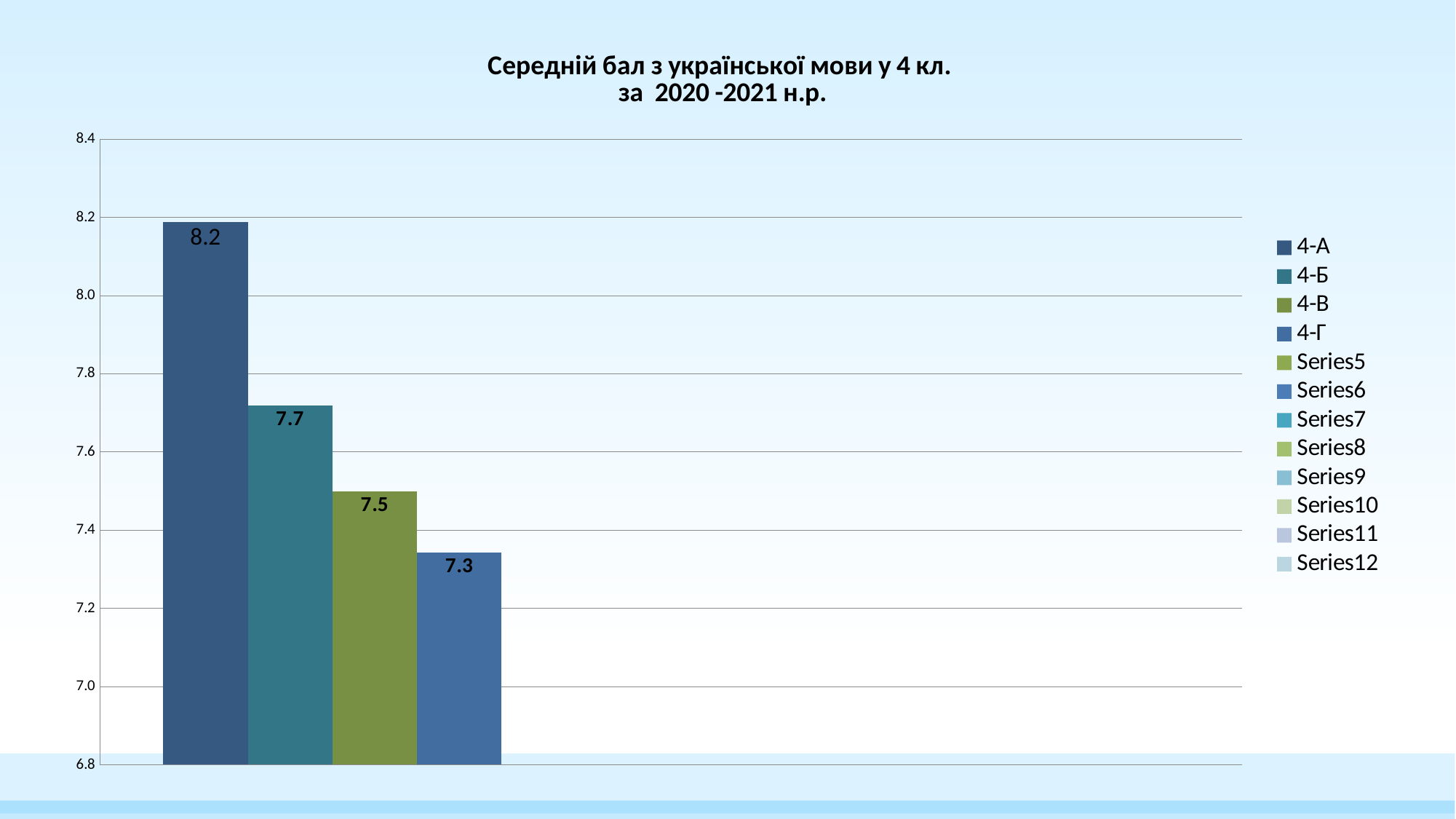
What type of chart is shown on the slide? Bar chart How many bars are plotted on the chart? 4 What is the difference between the scores of 4-А and 4-Б? 0.5 Which class has a higher score, 4-Б or 4-В? 4-Б What is the average score for class 4-Б? 7.7 What is the average score for class 4-А? 8.2 Which class has the highest average score? 4-А What is the average score for class 4-Г? 7.3 Which class has the lowest average score? 4-Г What is the difference between the scores of 4-А and 4-Г? 0.9 What is the average score for class 4-В? 7.5 How many entries does the legend list? 12